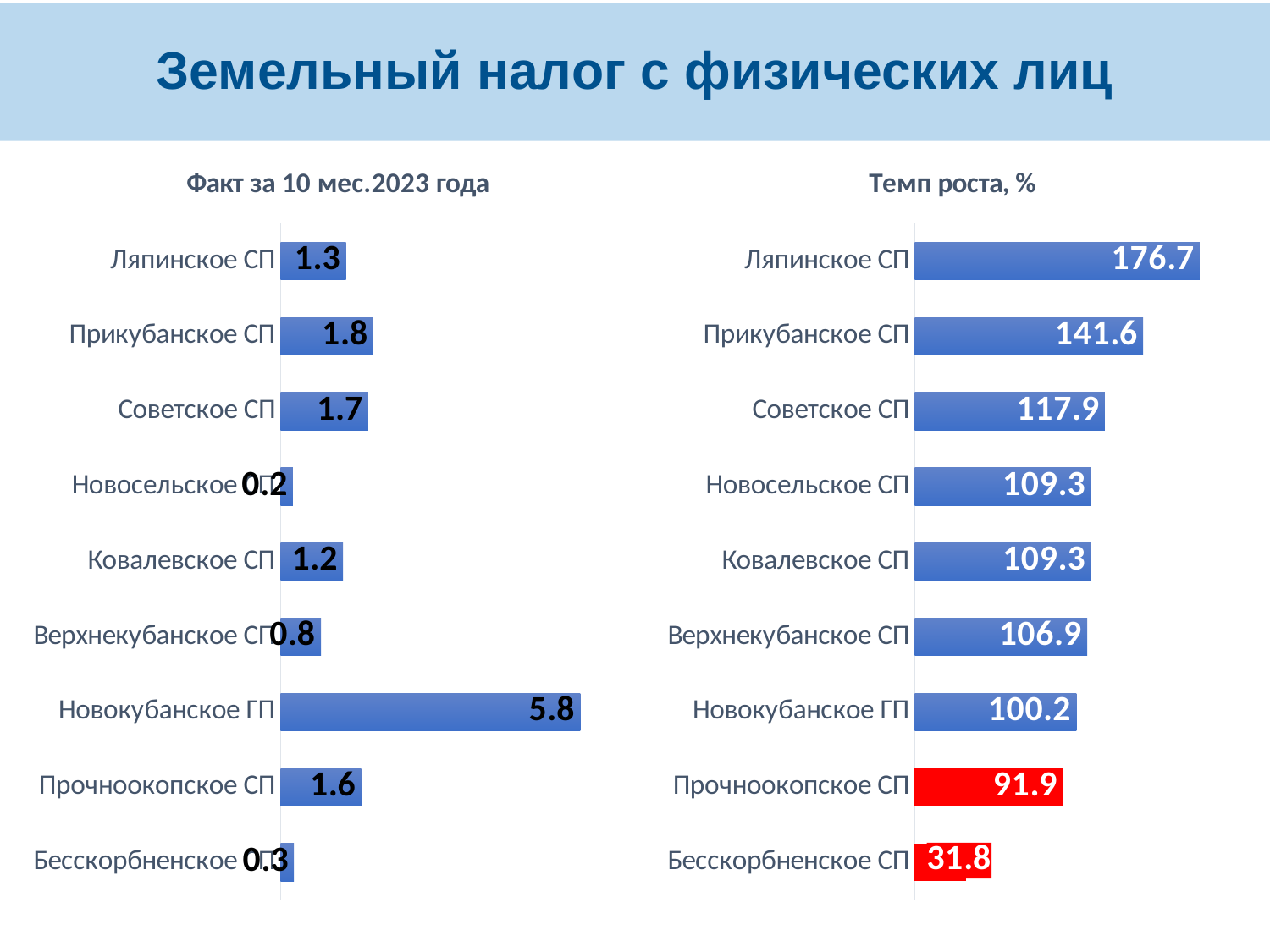
How many categories are shown in the chart titled "Темп роста, %"? 9 In the chart titled "Темп роста, %", what is the value for Бесскорбненское СП? 31.8 In the chart titled "Темп роста, %", which is larger: the value for Советское СП or the value for Прочноокопское СП? Советское СП In the chart titled "Факт за 10 мес.2023 года", which category has the highest value? Новокубанское ГП In the chart titled "Темп роста, %", which categories have red bars? Прочноокопское СП and Бесскорбненское СП In the chart titled "Факт за 10 мес.2023 года", which category has the lowest value? Новосельское СП In the chart titled "Темп роста, %", what is the difference between the values for Ляпинское СП and Прикубанское СП? 35.1 In the chart titled "Темп роста, %", what is the value for Ляпинское СП? 176.7 In the chart titled "Темп роста, %", which category has the lowest value? Бесскорбненское СП What kind of chart is the chart titled "Факт за 10 мес.2023 года"? Bar chart In the chart titled "Факт за 10 мес.2023 года", what is the value for Новокубанское ГП? 5.8 In the chart titled "Факт за 10 мес.2023 года", what is the difference between the values for Новокубанское ГП and Прикубанское СП? 4.0